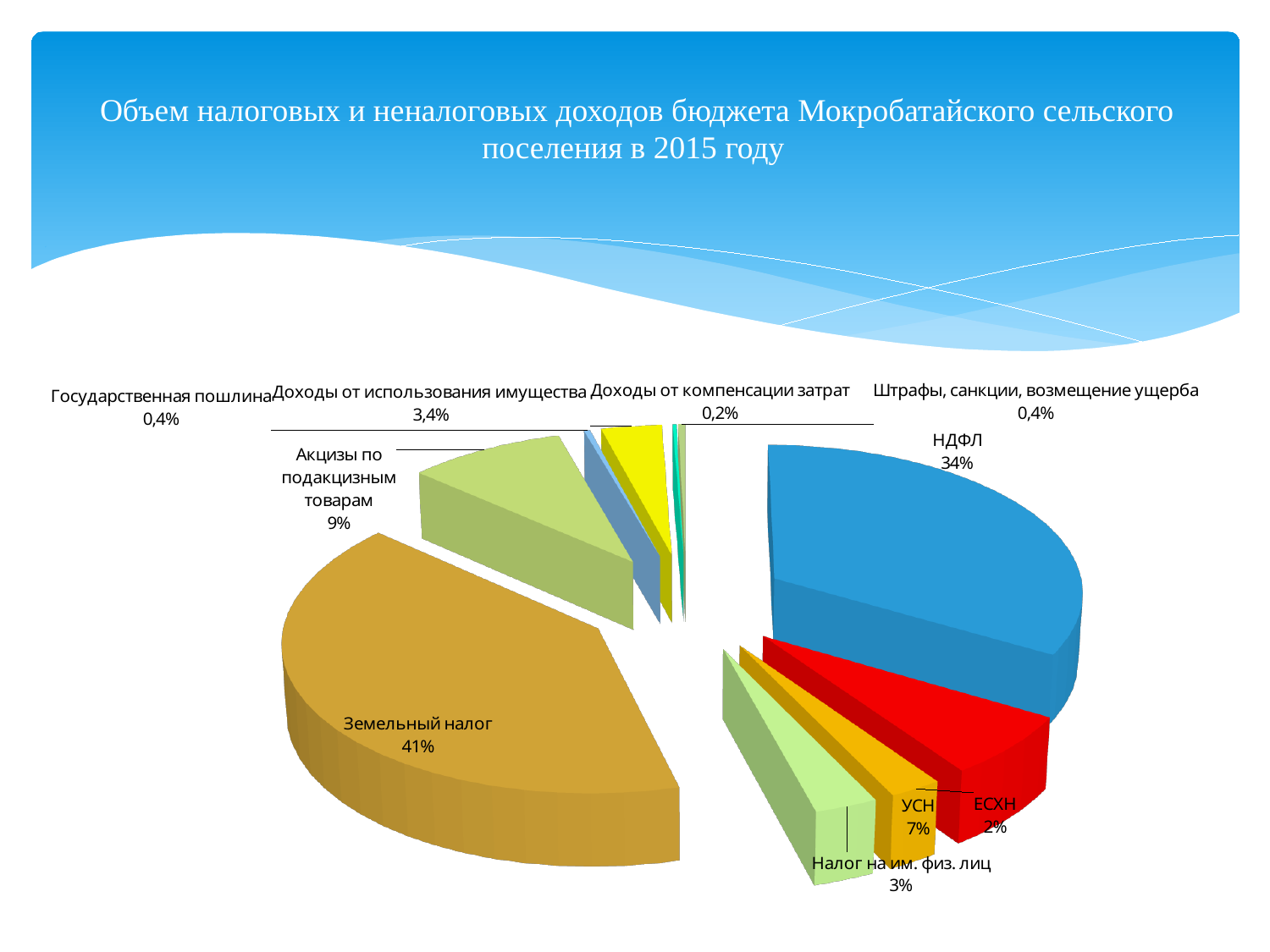
What kind of chart is shown on the slide? Pie chart What share of the pie does Земельный налог have? 41% What is the value shown for Доходы от компенсации затрат? 0,2% What is the title of the slide? Объем налоговых и неналоговых доходов бюджета Мокробатайского сельского поселения в 2015 году What is the value shown for Акцизы по подакцизным товарам? 9% Which category has the smallest share of the pie? Доходы от компенсации затрат What is the difference between the shares of Земельный налог and НДФЛ? 7% What share of the pie does НДФЛ have? 34% Which category has the largest share of the pie? Земельный налог Which is larger, the share of УСН or the share of Налог на им. физ. лиц? УСН How many slices does the pie chart have? 10 What is the value shown for Доходы от использования имущества? 3,4%